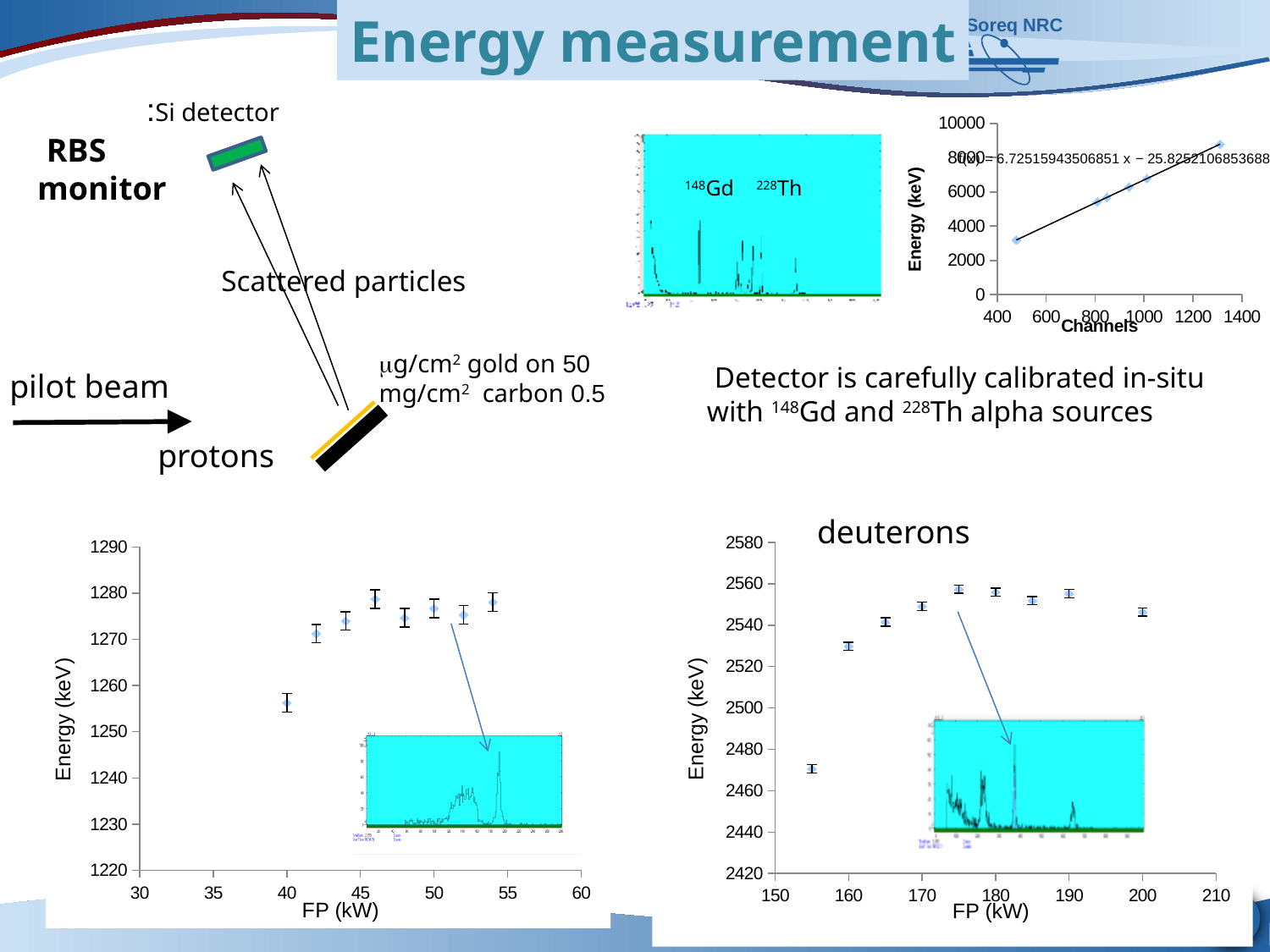
In the top-right calibration chart, do the energy values rise or fall as the channel number increases? rise In the bottom-right deuterons chart, is the energy at FP 155 kW greater or less than 2480? less What is the x-axis title of the top-right calibration chart? Channels In the bottom-left protons chart, is the energy at FP 40 kW greater or less than 1260? less In the top-right calibration chart, is the energy value for the lowest-channel point (near channel 480) greater or less than 4000? less In the bottom-right deuterons chart, how many data points are plotted? 9 In the bottom-left protons chart, at which FP (kW) value is the energy lowest? 40 In the bottom-left protons chart, how many data points are plotted? 8 In the bottom-left protons chart, which has the higher energy: the point at FP 40 kW or the point at FP 50 kW? 50 kW In the bottom-right deuterons chart, at which FP (kW) value is the energy lowest? 155 What kind of chart is the top-right chart of Energy (keV) versus Channels? scatter chart